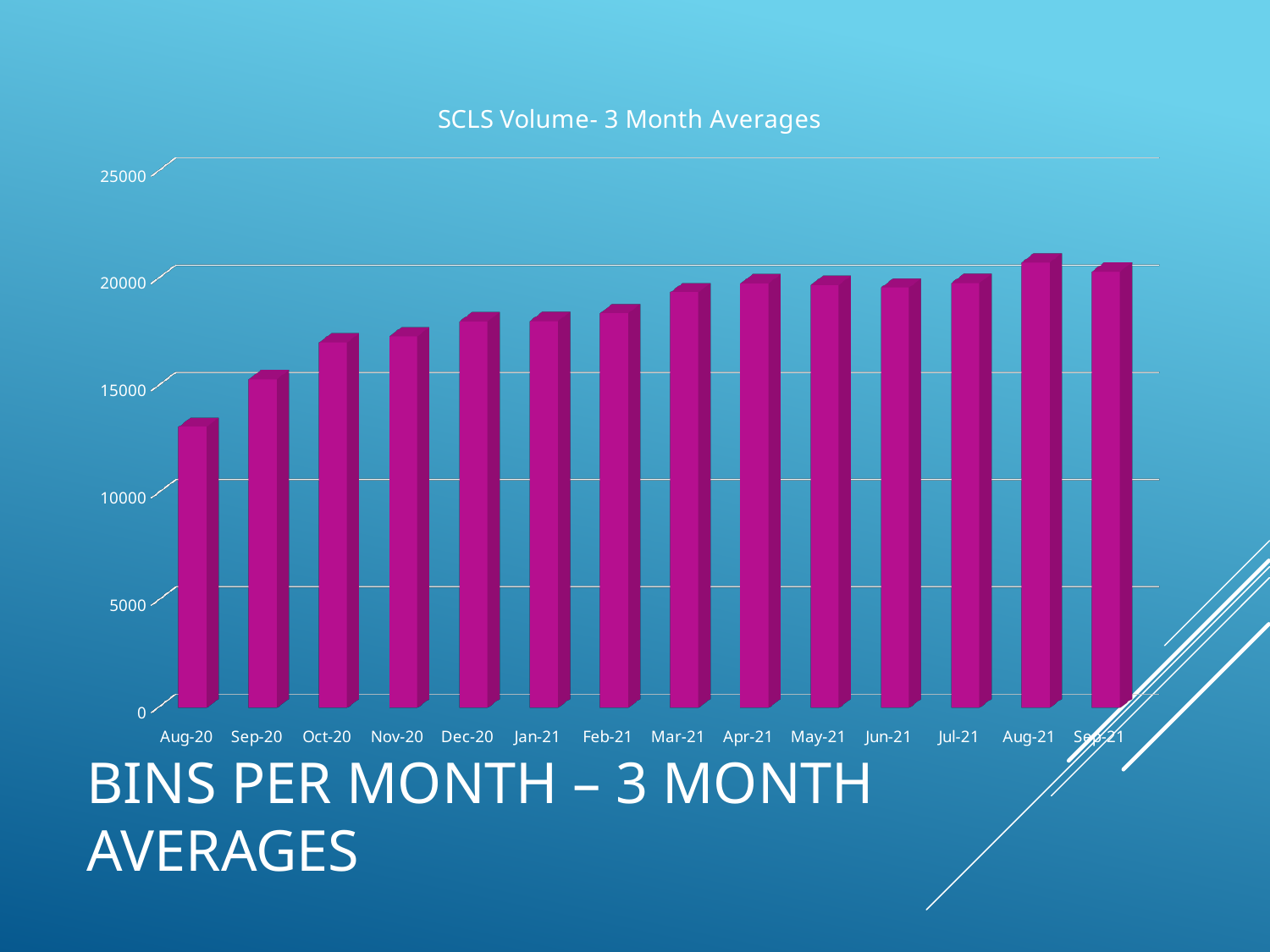
Is the value for Aug-20 greater or less than 15000? less Is the value for Dec-20 greater or less than 20000? less Which is larger, the value for Aug-20 or the value for Aug-21? Aug-21 Which month has the lowest value in the chart? Aug-20 How many months are shown on the x axis of the chart? 14 Is the value for Aug-21 greater or less than 20000? greater What is the title of the chart? SCLS Volume- 3 Month Averages Which month has the highest value in the chart? Aug-21 Do the values generally rise or fall from Aug-20 to Sep-21? rise What type of chart is shown on the slide? Bar chart